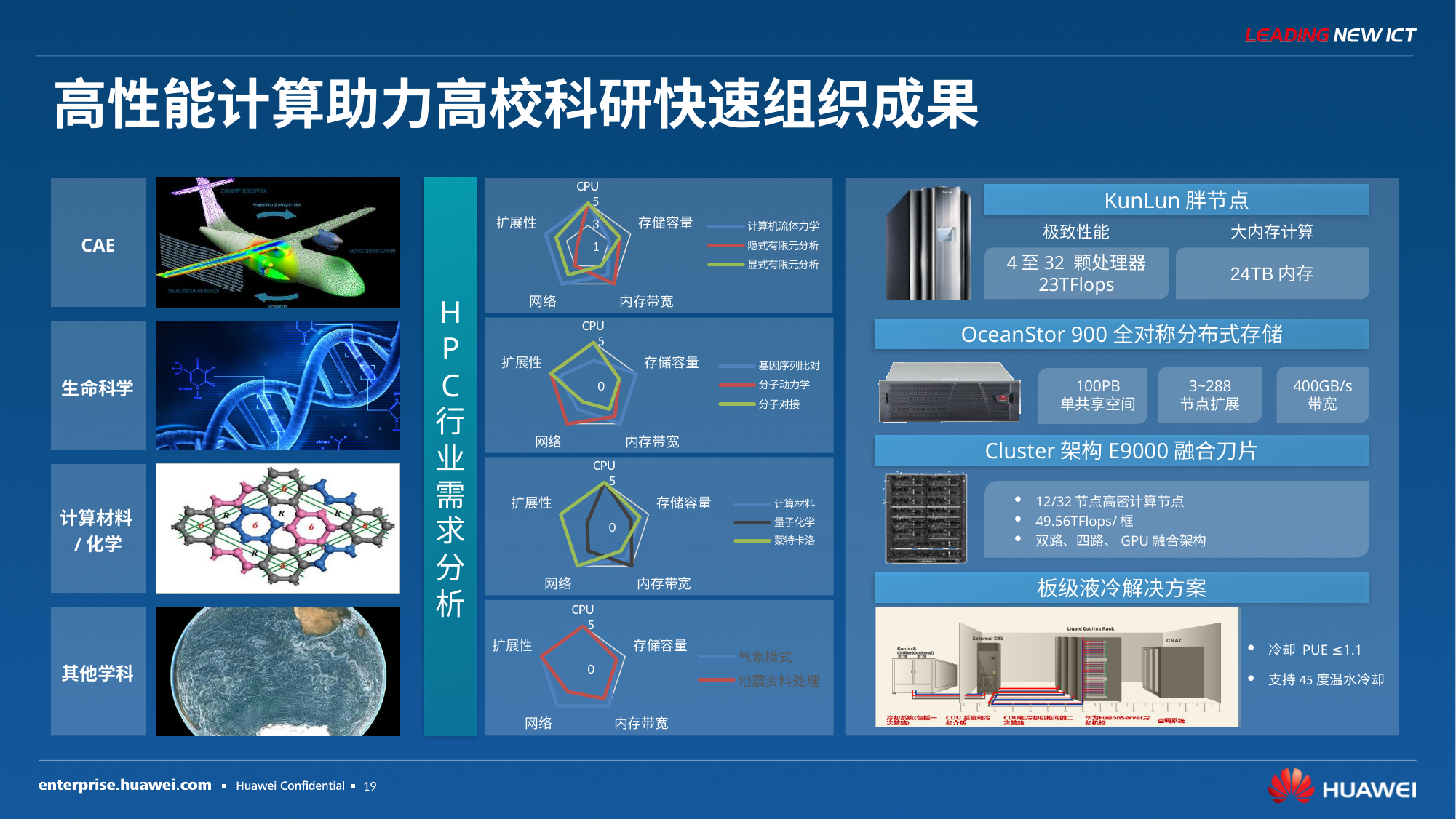
How many series does the legend of the second radar chart from the top (基因序列比对 etc.) list? 3 In the third radar chart from the top (计算材料, 量子化学, 蒙特卡洛), which series has the larger value on the 扩展性 axis: 蒙特卡洛 or 量子化学? 蒙特卡洛 What kind of chart is the top chart in the middle column (legend 计算机流体力学, 隐式有限元分析, 显式有限元分析)? radar chart How many series does the legend of the top radar chart (计算机流体力学 etc.) list? 3 How many series does the legend of the third radar chart from the top (计算材料 etc.) list? 3 How many axes (categories) does the top radar chart in the middle column have? 5 What is the maximum value shown on the axis scale of the top radar chart in the middle column? 5 How many axes does the bottom radar chart (气象模式, 地震资料处理) have? 5 How many radar charts are shown in the middle column of the slide? 4 Which series are listed in the legend of the bottom radar chart in the middle column? 气象模式, 地震资料处理